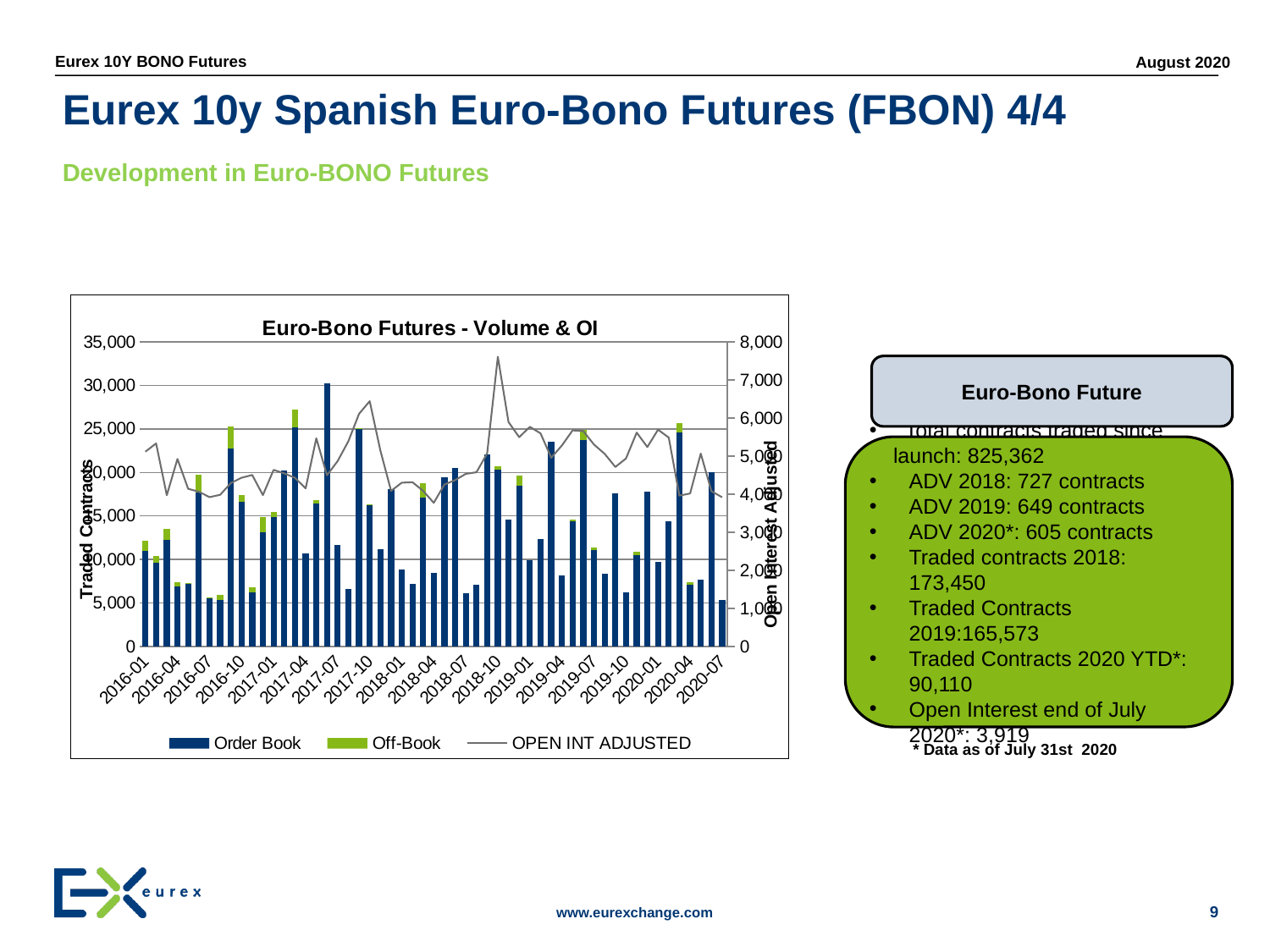
Around which month does the OPEN INT ADJUSTED line reach its peak? 2018-10 What is the highest tick value shown on the left (Traded Contracts) axis? 35,000 Which series is drawn as a line rather than bars? OPEN INT ADJUSTED Is the total traded contracts bar for 2016-01 greater or less than 15,000? less Is the total traded contracts bar for 2020-07 greater or less than 10,000? less Is the OPEN INT ADJUSTED line at 2018-10 greater or less than 7,000? greater What kind of chart is used to show Order Book and Off-Book volumes? bar chart What is the title of the chart on the slide? Euro-Bono Futures - Volume & OI How many series does the chart legend list? 3